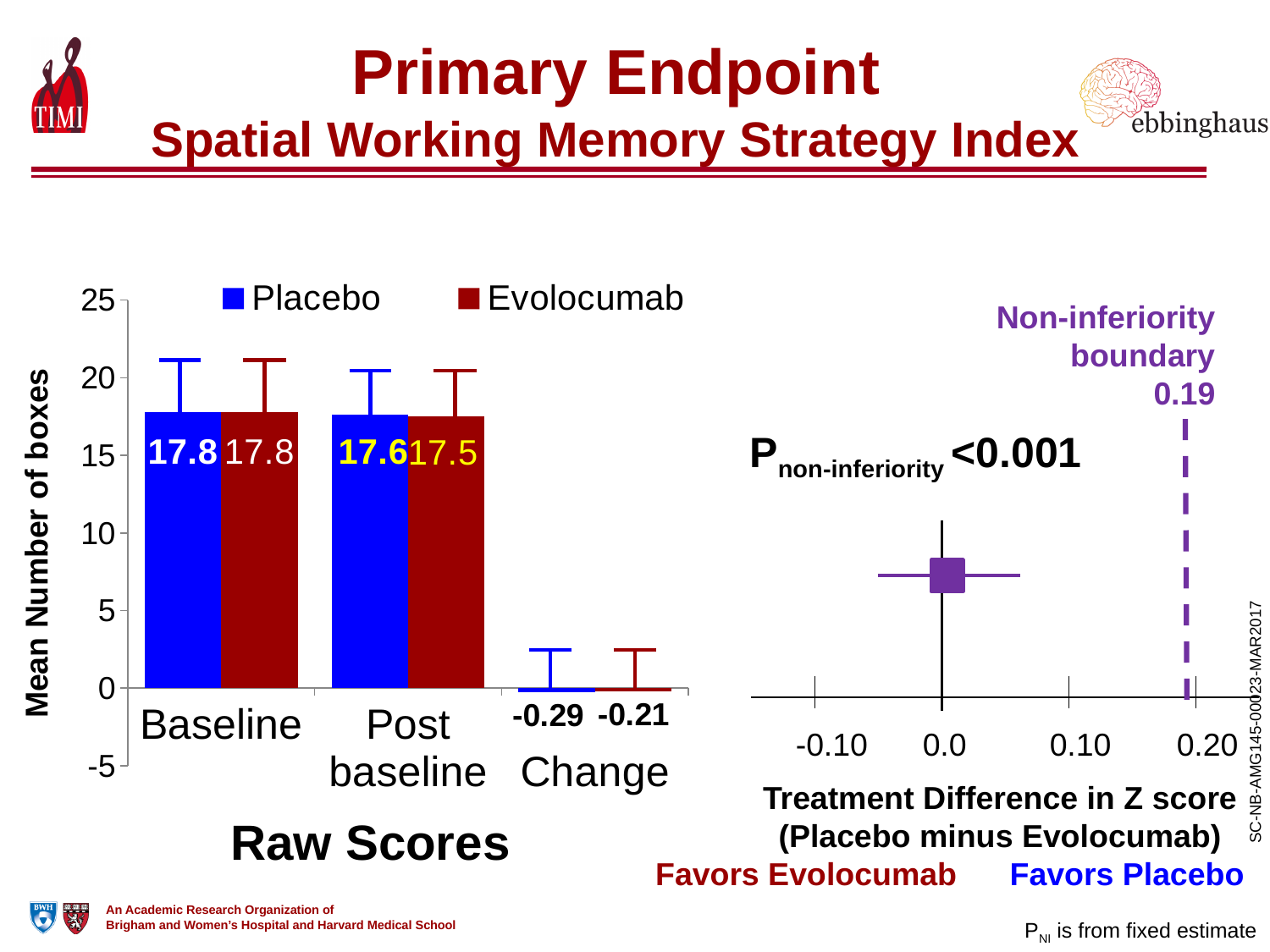
In the Raw Scores bar chart, how many series does the legend list? 2 In the Raw Scores bar chart, what is the Evolocumab value at Post baseline? 17.5 In the Raw Scores bar chart, what is the Placebo value for Change? -0.29 In the Raw Scores bar chart, which is larger at Post baseline, the Placebo value or the Evolocumab value? Placebo In the Raw Scores bar chart, what is the difference between the Placebo and Evolocumab values at Post baseline? 0.1 In the right-hand chart of Treatment Difference in Z score, what is the non-inferiority boundary value? 0.19 In the Raw Scores bar chart, how many categories are shown on the x axis? 3 In the Raw Scores bar chart, what is the Evolocumab value for Change? -0.21 What kind of chart is the Raw Scores chart on the left? Bar chart In the Raw Scores bar chart, what is the y-axis label? Mean Number of boxes In the right-hand chart of Treatment Difference in Z score, is the plotted point estimate greater or less than 0.10? less In the Raw Scores bar chart, what is the Placebo value at Baseline? 17.8